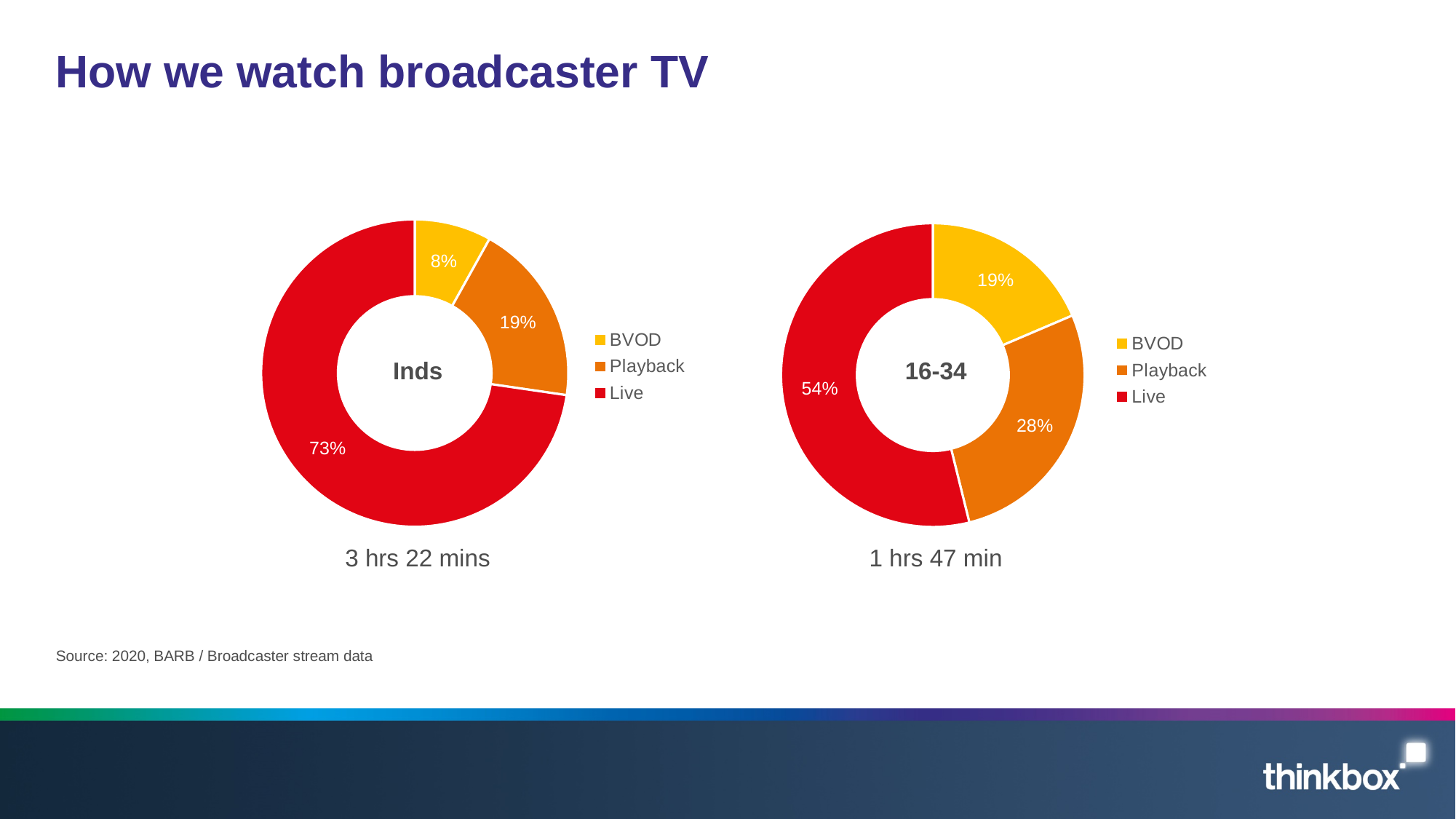
What is the difference in percentage points between the Live share in the Inds chart and the Live share in the 16-34 chart? 19 percentage points In the 16-34 chart, what share of viewing is Live? 54% In the Inds chart, what share of viewing is BVOD? 8% In the 16-34 chart, what share of viewing is Playback? 28% Which chart shows a larger BVOD share, Inds or 16-34? 16-34 In the Inds chart, what share of viewing is Live? 73% In the Inds chart, which category has the smallest share? BVOD What type of chart is used on this slide? Donut (pie) chart How many categories does each donut chart show? 3 Which colour represents Playback in the legend? Orange What total viewing time is shown beneath the Inds chart? 3 hrs 22 mins In the 16-34 chart, which category has the largest share? Live